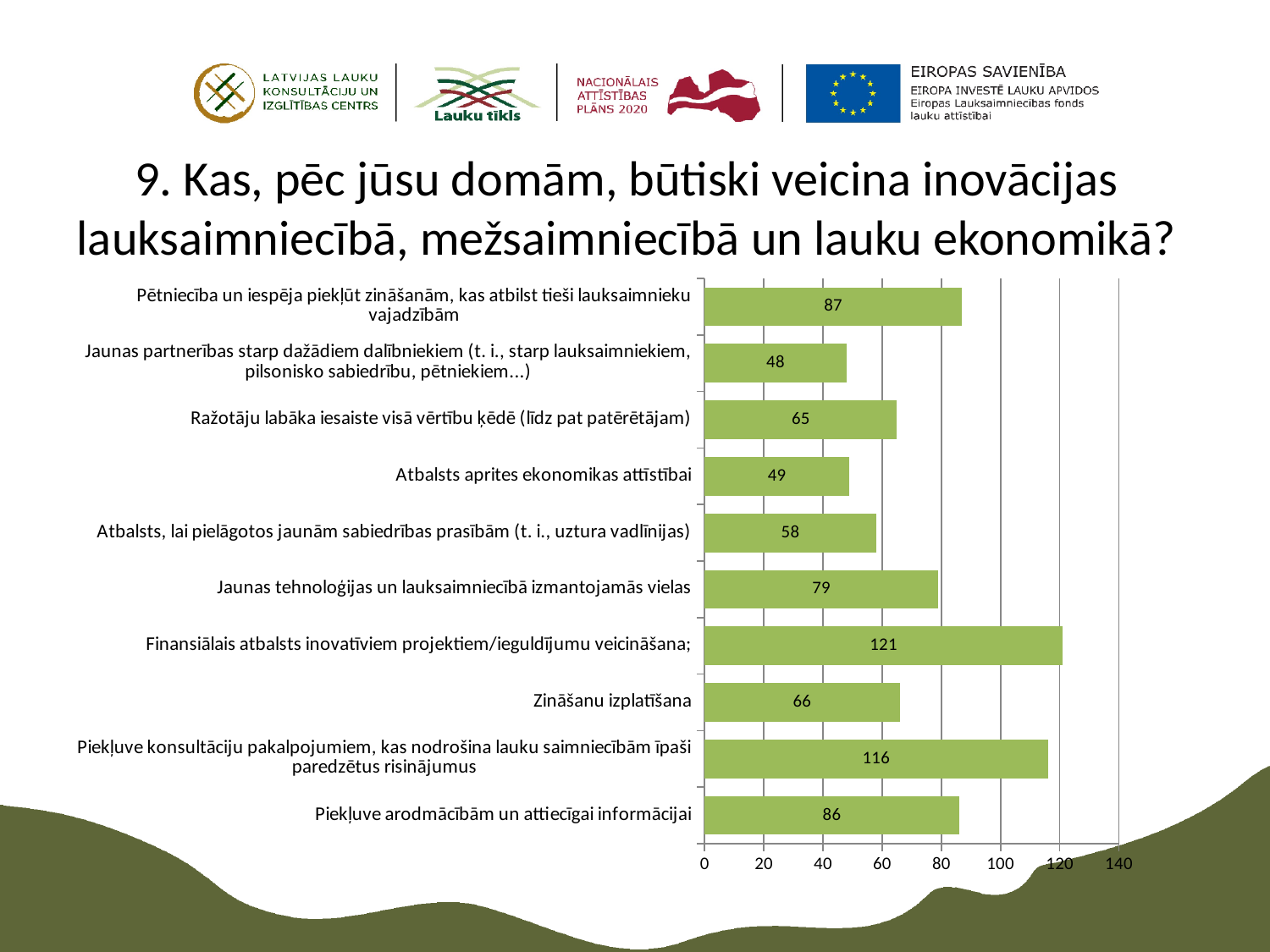
Which category has the highest value? Finansiālais atbalsts inovatīviem projektiem/ieguldījumu veicināšana What is the value for "Zināšanu izplatīšana"? 66 What is the difference between the values for "Pētniecība un iespēja piekļūt zināšanām, kas atbilst tieši lauksaimnieku vajadzībām" and "Atbalsts, lai pielāgotos jaunām sabiedrības prasībām (t. i., uztura vadlīnijas)"? 29 Is the value for "Ražotāju labāka iesaiste visā vērtību ķēdē (līdz pat patērētājam)" greater or less than 60? greater Which is larger: the value for "Piekļuve arodmācībām un attiecīgai informācijai" or for "Jaunas tehnoloģijas un lauksaimniecībā izmantojamās vielas"? Piekļuve arodmācībām un attiecīgai informācijai What is the value for "Jaunas tehnoloģijas un lauksaimniecībā izmantojamās vielas"? 79 What kind of chart is shown on the slide? bar chart What is the difference between the values for "Finansiālais atbalsts inovatīviem projektiem/ieguldījumu veicināšana" and "Piekļuve konsultāciju pakalpojumiem, kas nodrošina lauku saimniecībām īpaši paredzētus risinājumus"? 5 What is the value for "Atbalsts aprites ekonomikas attīstībai"? 49 What is the highest tick value shown on the horizontal axis? 140 Which category has the lowest value? Jaunas partnerības starp dažādiem dalībniekiem (t. i., starp lauksaimniekiem, pilsonisko sabiedrību, pētniekiem...) How many categories are shown in the chart? 10